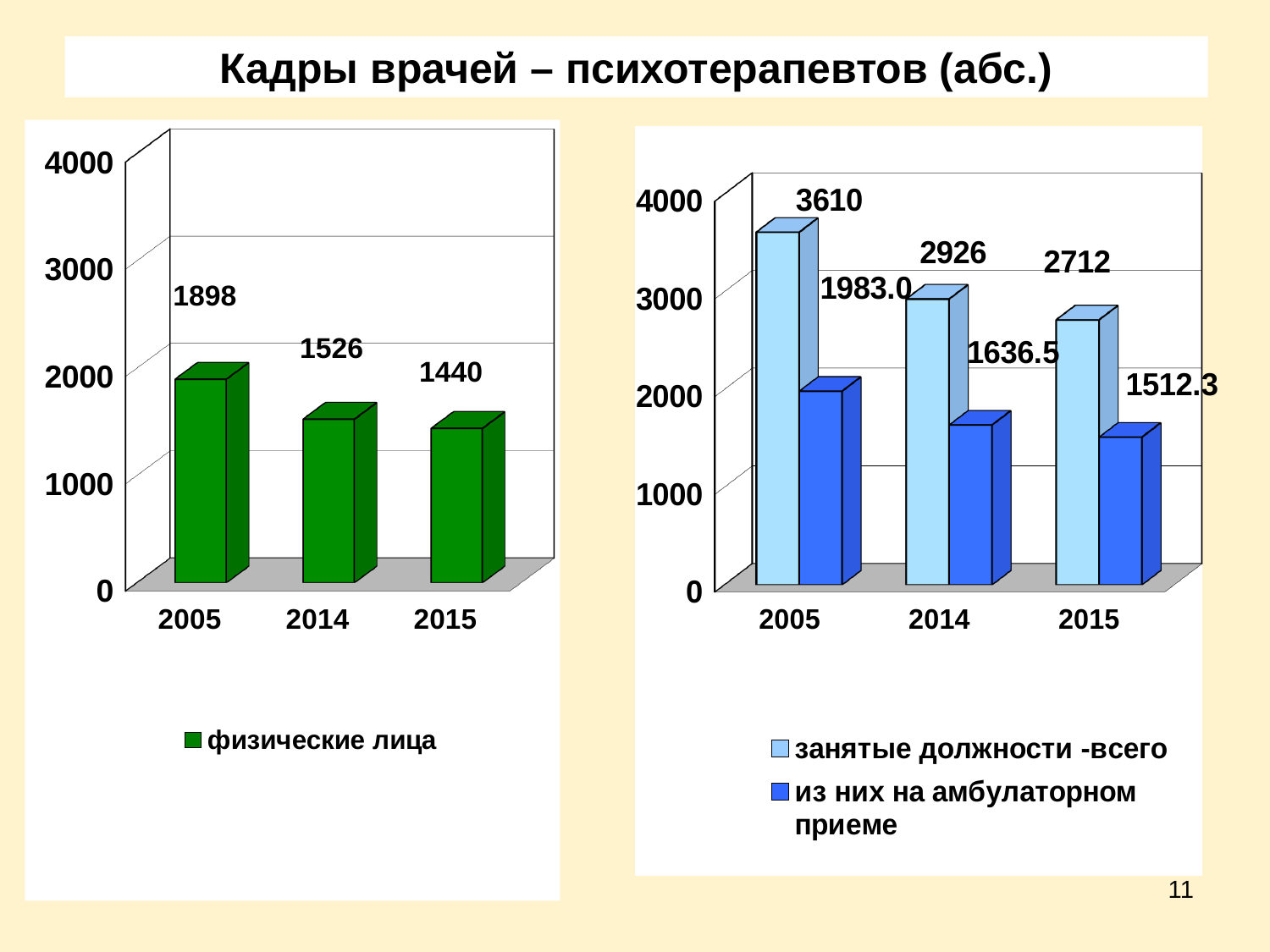
How many series does the legend of the right chart list? 2 In the left chart, what is the difference between the 2005 and 2014 values? 372 In the right chart, what is the difference between занятые должности -всего and из них на амбулаторном приеме in 2005? 1627.0 In the right chart, what is the value for занятые должности -всего in 2014? 2926 In the left chart, do the values rise or fall from 2005 to 2015? fall In the left chart, what is the value for физические лица in 2005? 1898 What kind of chart is the left chart? bar chart In the right chart, which year has the highest value for занятые должности -всего? 2005 In the right chart, which is larger in 2014: занятые должности -всего or из них на амбулаторном приеме? занятые должности -всего In the left chart, which year has the lowest value? 2015 In the left chart, what is the value for физические лица in 2015? 1440 In the right chart, what is the value for из них на амбулаторном приеме in 2015? 1512.3